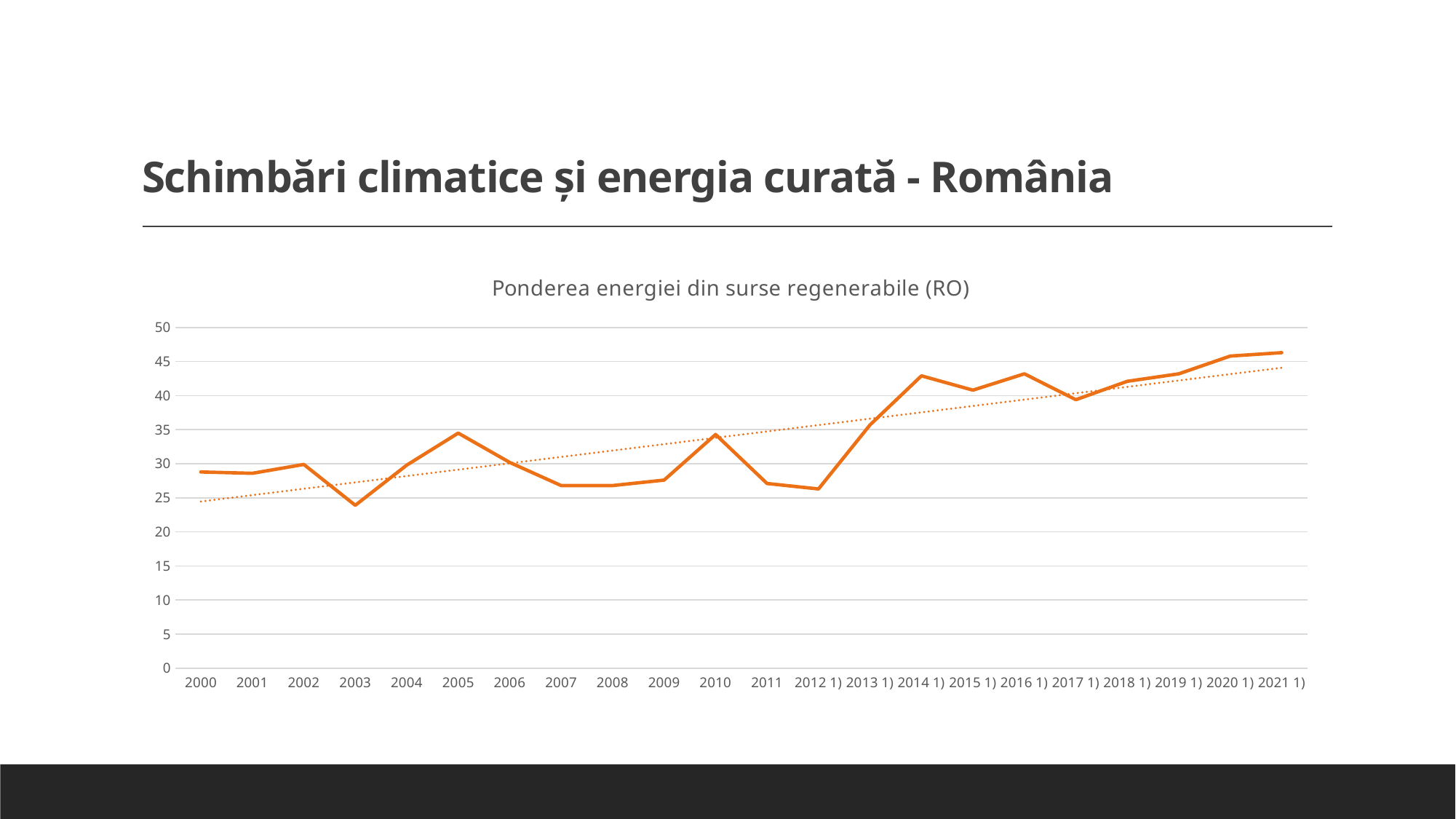
Is the value for 2003 greater or less than 25? less Which year has the highest value? 2021 1) How many years are plotted along the x axis? 22 Which is larger, the value for 2013 1) or the value for 2012 1)? 2013 1) Overall, do the values rise or fall from 2000 to 2021 1)? rise Which year has the lowest value? 2003 Is the value for 2000 greater or less than 30? less Is the value for 2021 1) greater or less than 45? greater What type of chart is shown on the slide? line chart What is the title of the chart? Ponderea energiei din surse regenerabile (RO) Which is larger, the value for 2014 1) or the value for 2010? 2014 1)